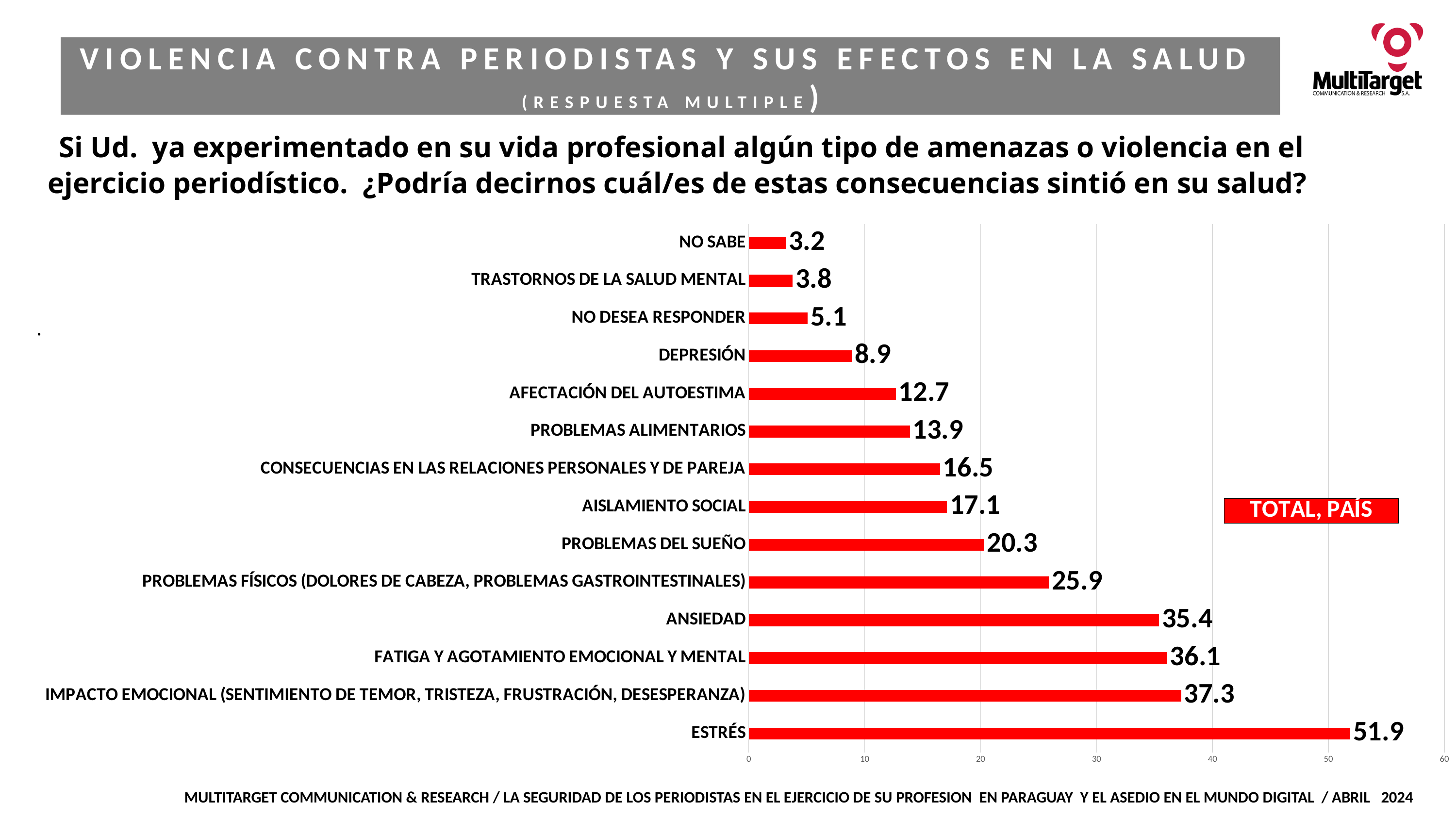
Which category has the lowest value? NO SABE What is the value for ESTRÉS? 51.9 What label appears in the red box to the right of the chart? TOTAL, PAÍS What is the value for DEPRESIÓN? 8.9 What is the value for ANSIEDAD? 35.4 What kind of chart is shown on the slide? bar chart Is the value for PROBLEMAS FÍSICOS (DOLORES DE CABEZA, PROBLEMAS GASTROINTESTINALES) greater or less than 20? greater Which is larger, the value for PROBLEMAS DEL SUEÑO or the value for AISLAMIENTO SOCIAL? PROBLEMAS DEL SUEÑO What is the difference between the values for ESTRÉS and IMPACTO EMOCIONAL (SENTIMIENTO DE TEMOR, TRISTEZA, FRUSTRACIÓN, DESESPERANZA)? 14.6 How many categories are shown in the chart? 14 Which category has the highest value? ESTRÉS What is the difference between the values for FATIGA Y AGOTAMIENTO EMOCIONAL Y MENTAL and ANSIEDAD? 0.7